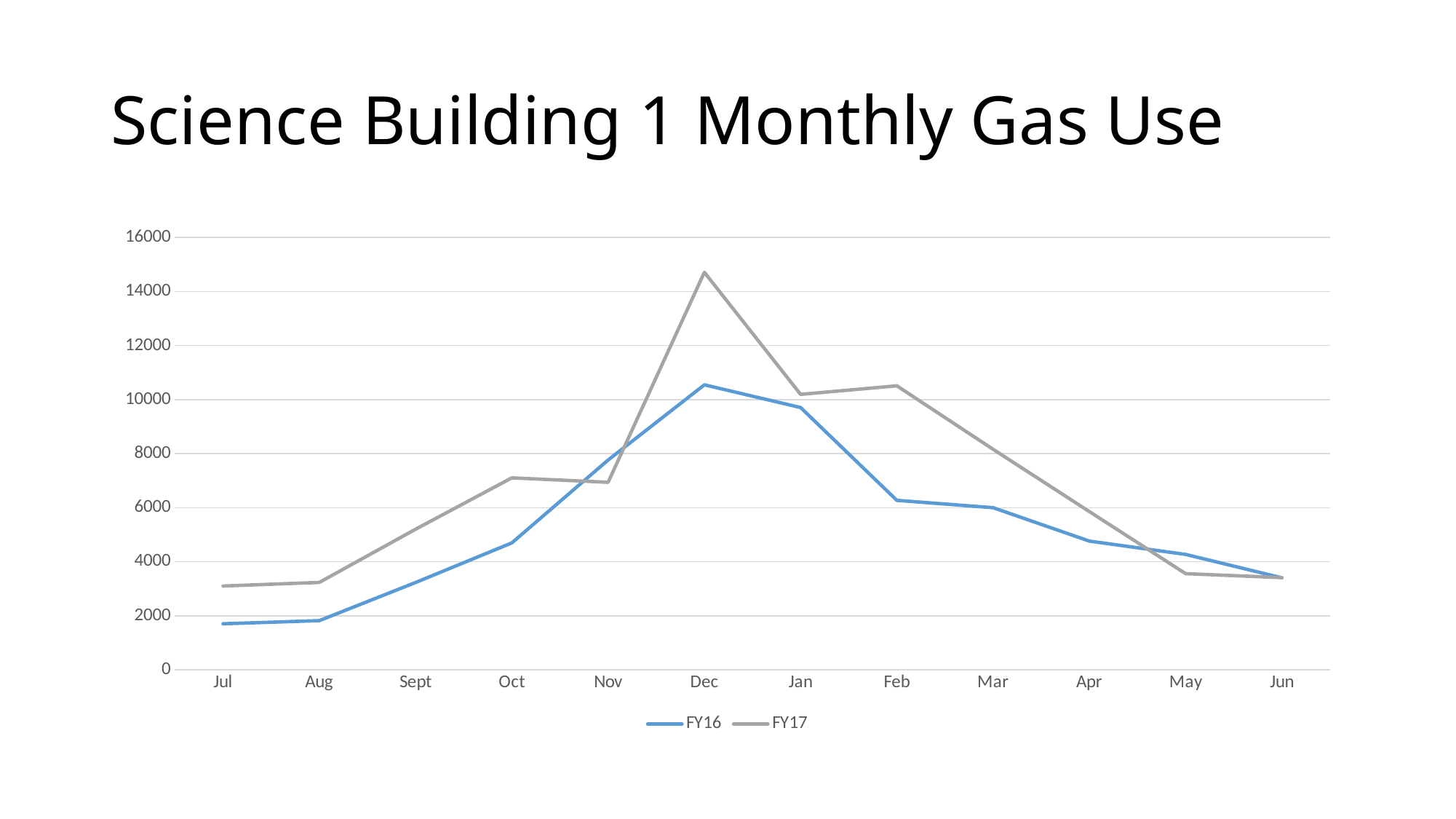
How many months are plotted along the x axis? 12 How many series does the legend list? 2 Which series has the higher value in Feb, FY16 or FY17? FY17 What kind of chart is shown on the slide? line chart Is the FY17 value for Oct greater or less than 6000? greater Is the FY17 value for Dec greater or less than 14000? greater What is the title of the chart? Science Building 1 Monthly Gas Use In which month is the FY16 series at its lowest value? Jul In which month does the FY16 series reach its highest value? Dec Does the FY16 series rise or fall from Dec to Jun? fall In which month does the FY17 series reach its highest value? Dec Is the FY16 value for Jul greater or less than 2000? less